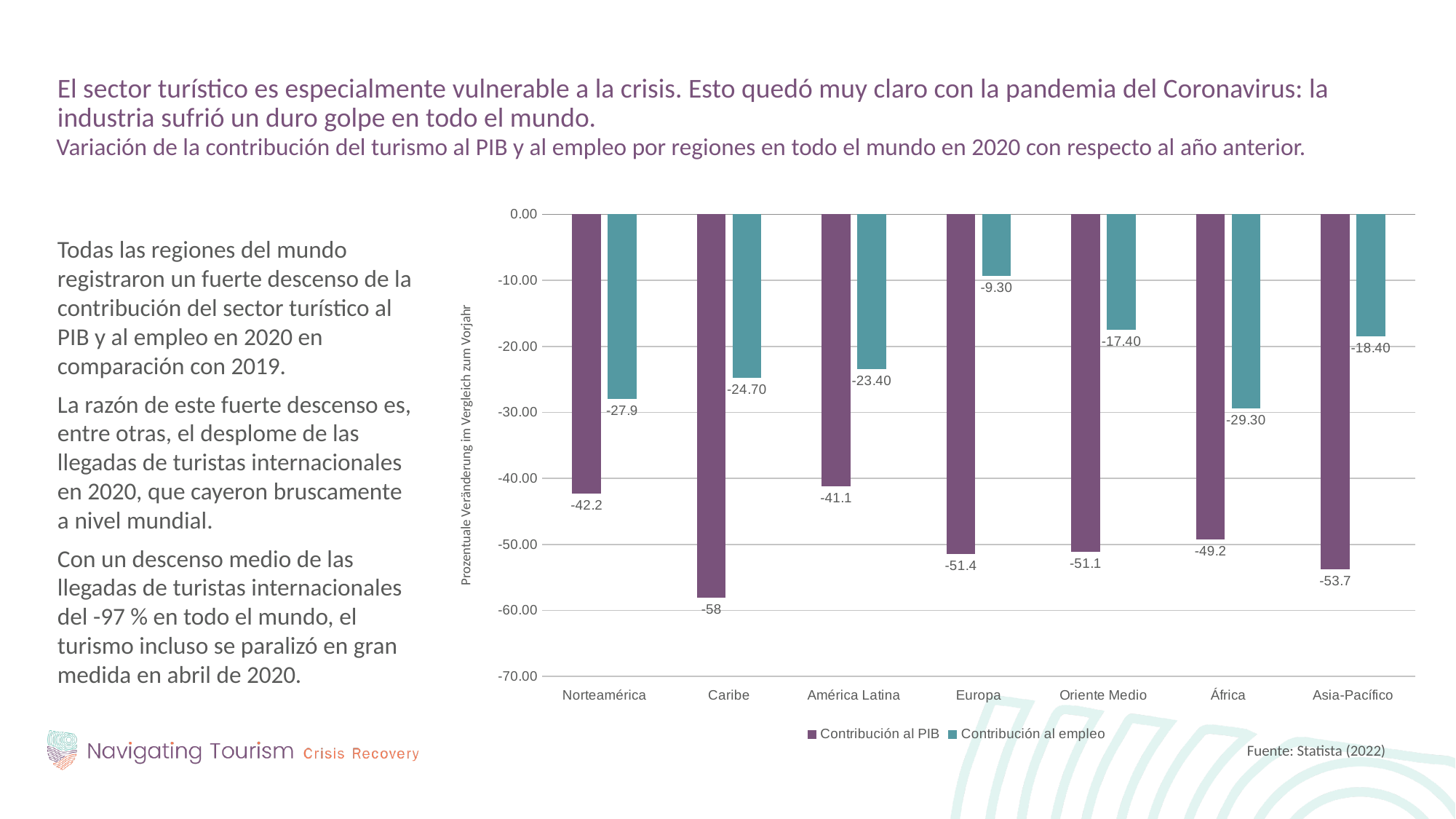
What is the value for Contribución al PIB for Caribe? -58 How many regions are shown on the x axis of the chart? 7 What is the value for Contribución al PIB for Asia-Pacífico? -53.7 Which region has the least negative value for Contribución al empleo? Europa Which region shows the smaller decline in Contribución al empleo, Europa or Oriente Medio? Europa Is the Contribución al PIB value for Caribe greater or less than -50.00? less What kind of chart is shown on the slide? bar chart How many series does the chart's legend list? 2 What is the value for Contribución al empleo for Europa? -9.30 Which region has the most negative value for Contribución al PIB? Caribe What is the value for Contribución al empleo for África? -29.30 What is the difference between the Contribución al PIB values for Caribe and Norteamérica? 15.8